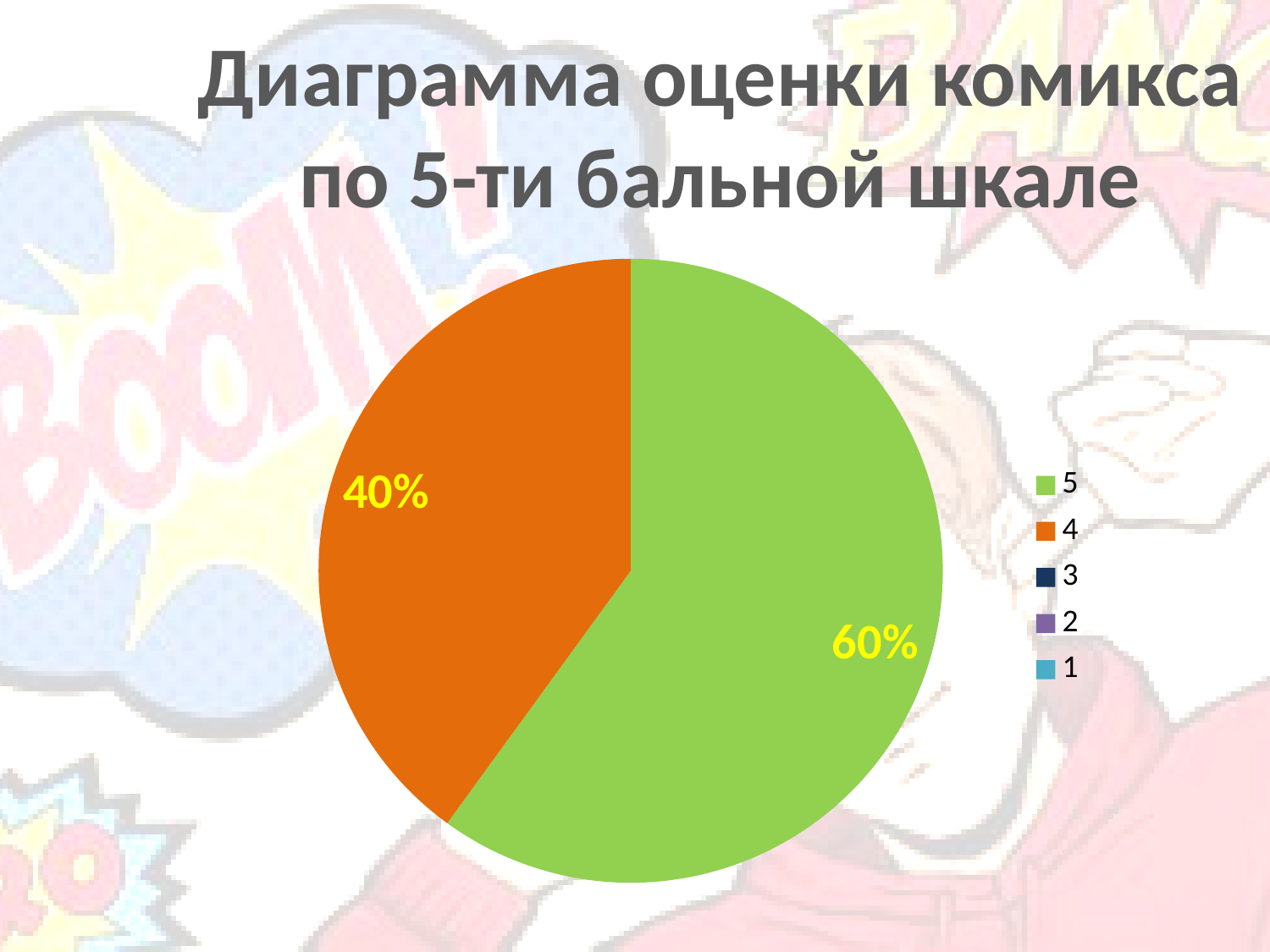
Which rating has the largest slice of the pie? 5 What is the total of the two labelled slices? 100% What is the title of the chart? Диаграмма оценки комикса по 5-ти бальной шкале What share of the pie does the rating 4 take? 40% Which is larger, the slice for rating 5 or the slice for rating 4? 5 Is the share for rating 4 greater or less than 50%? less How many slices are visible in the pie? 2 What colour is the slice for rating 5? green What kind of chart is shown on the slide? pie chart What share of the pie does the rating 5 take? 60% How many entries does the legend list? 5 What is the difference between the share for rating 5 and the share for rating 4? 20%